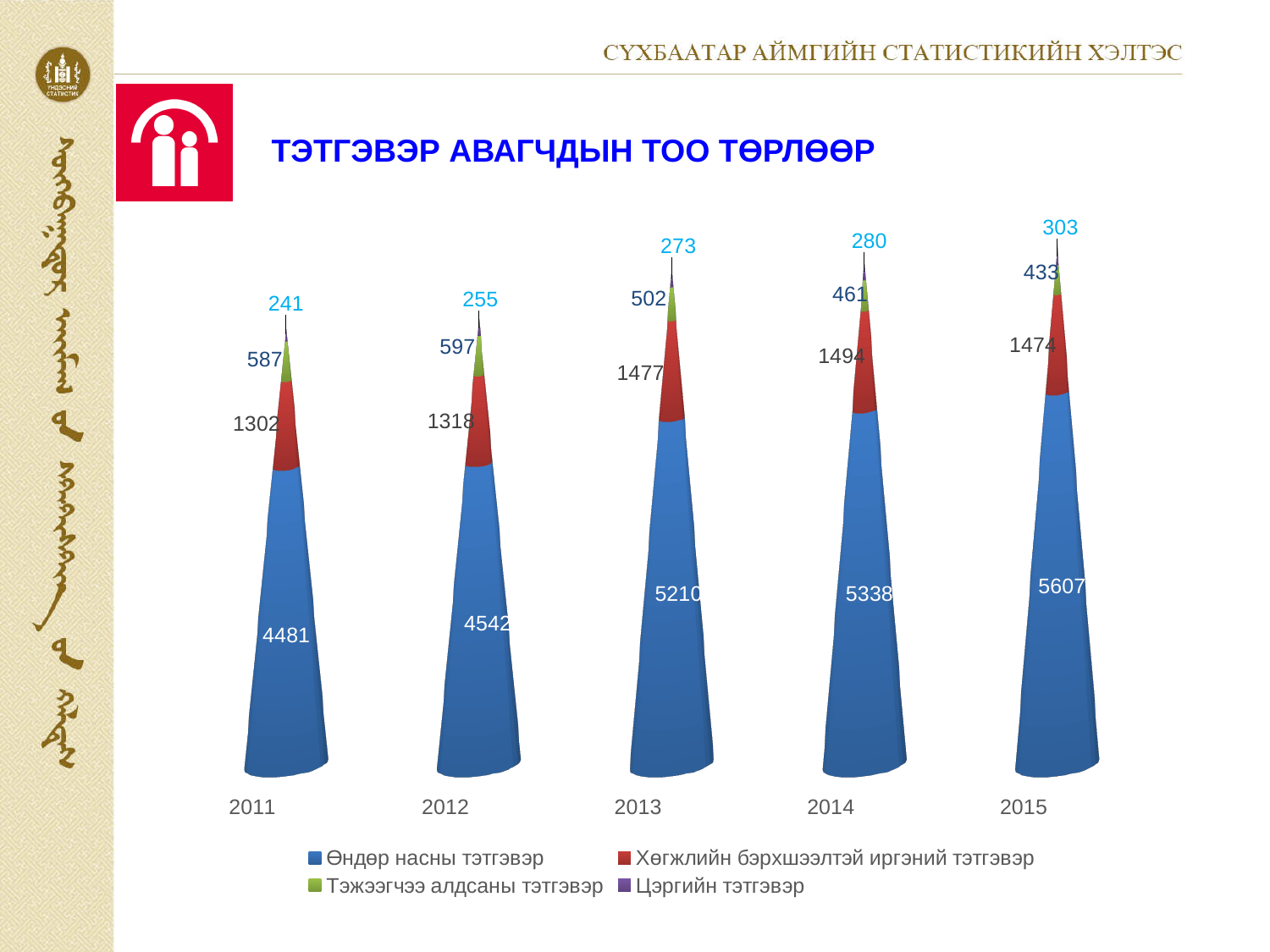
What is the value of Өндөр насны тэтгэвэр in 2015? 5607 What is the total of the stacked bar for 2011? 6611 In which year is Өндөр насны тэтгэвэр highest? 2015 What is the value of Цэргийн тэтгэвэр in 2014? 280 How many years are shown on the x axis? 5 What kind of chart is shown? stacked bar chart How many series does the legend list? 4 Which is larger: Хөгжлийн бэрхшээлтэй иргэний тэтгэвэр in 2014 or in 2015? 2014 What is the difference between Өндөр насны тэтгэвэр in 2015 and in 2011? 1126 In which year is Тэжээгчээ алдсаны тэтгэвэр lowest? 2015 What is the value of Хөгжлийн бэрхшээлтэй иргэний тэтгэвэр in 2013? 1477 What is the value of Тэжээгчээ алдсаны тэтгэвэр in 2011? 587